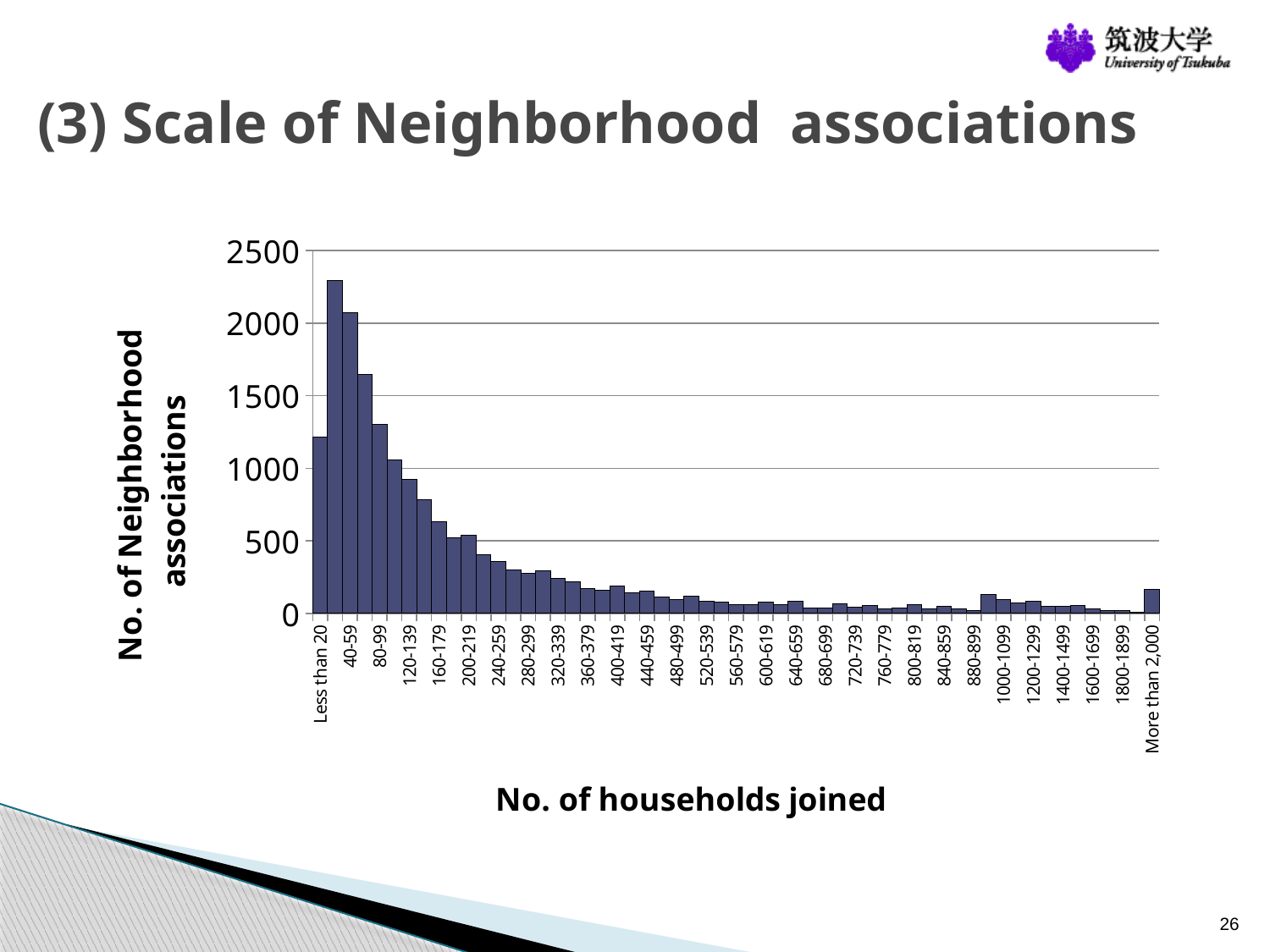
Which has a larger value, '80-99' or '120-139'? 80-99 Is the value for '80-99' greater or less than 1500? less Is the value for '120-139' greater or less than 1000? less Is the value for '160-179' greater or less than 500? greater Which has a larger value, 'Less than 20' or '40-59'? 40-59 After the peak near the left, do the values generally rise or fall as the number of households joined increases? fall What kind of chart is shown on the slide? bar chart What is the title of the horizontal axis? No. of households joined